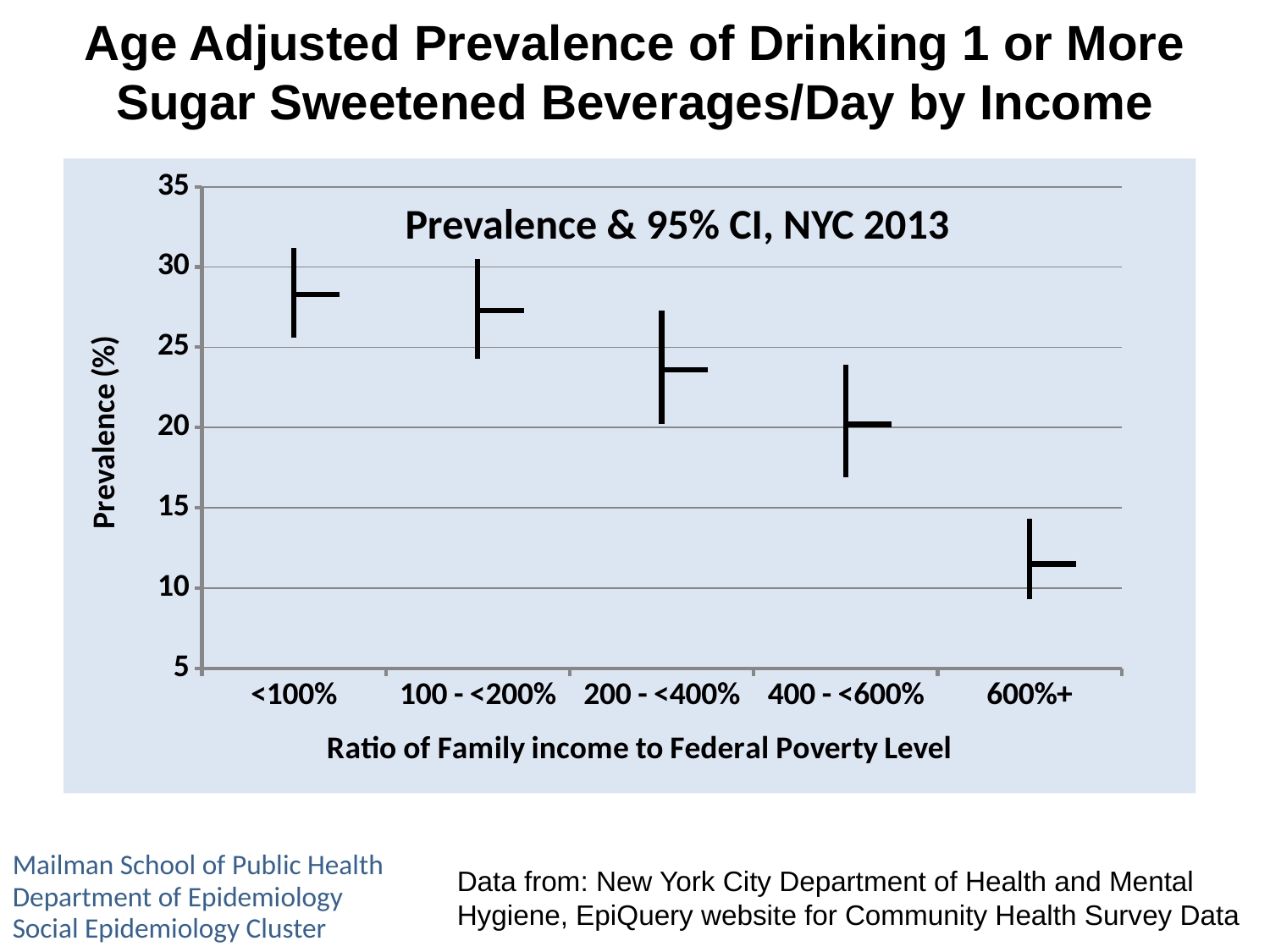
Is the prevalence for the 200 - <400% category greater or less than 25? less Does prevalence rise or fall as the ratio of family income to the federal poverty level increases? fall Which has the higher prevalence, the 200 - <400% category or the 400 - <600% category? 200 - <400% Which income category has the lowest prevalence? 600%+ Is the prevalence for the 100 - <200% category greater or less than 25? greater What is the label of the x axis? Ratio of Family income to Federal Poverty Level Which has the higher prevalence, the 400 - <600% category or the 600%+ category? 400 - <600% How many income categories are shown on the x axis? 5 Is the prevalence for the <100% category greater or less than 25? greater What is the title shown inside the chart area? Prevalence & 95% CI, NYC 2013 Which income category has the highest prevalence? <100%